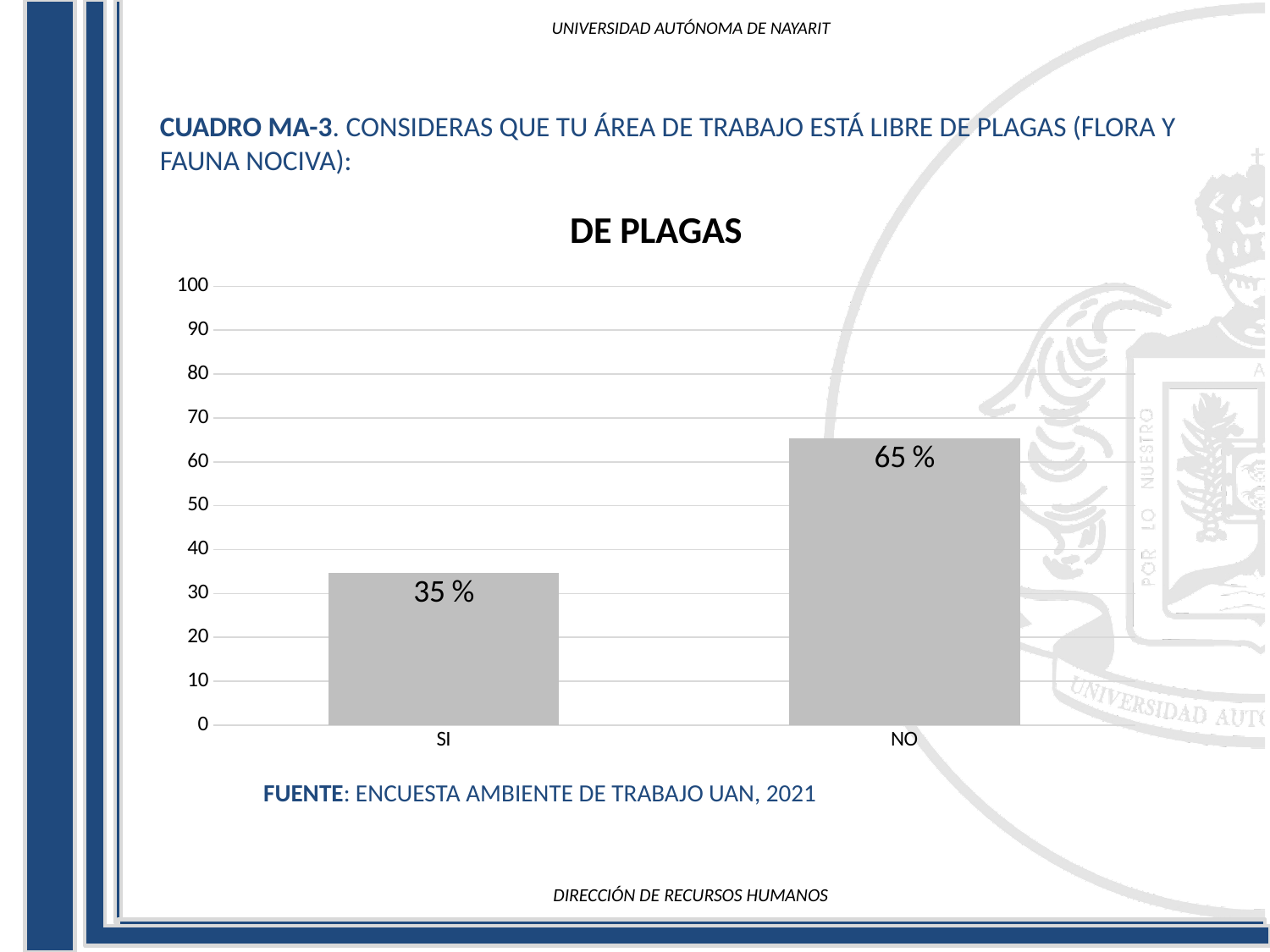
Is the value for NO greater or less than 50? greater What is the highest value shown on the y axis? 100 How many categories are shown on the x axis? 2 What is the difference between the values for NO and SI? 30 % Which is larger, the value for SI or the value for NO? NO What kind of chart is shown on the slide? bar chart What is the value for NO? 65 % Is the value for SI greater or less than 40? less What is the title of the chart? DE PLAGAS Which category has the highest value? NO Which category has the lowest value? SI What is the value for SI? 35 %